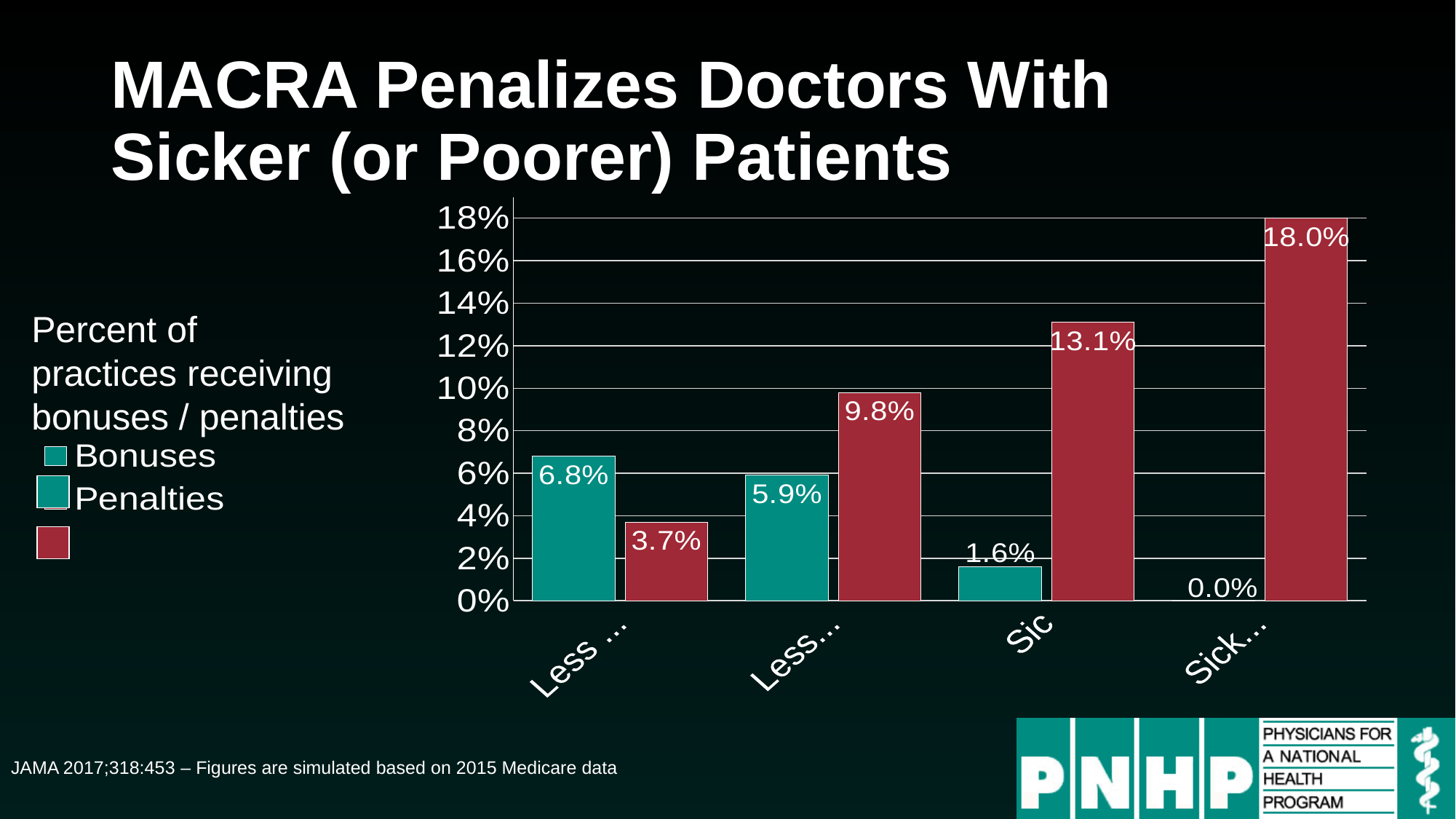
What is the Penalties value for the second category group from the left? 9.8% What is the difference between the Penalties value and the Bonuses value in the third category group from the left? 11.5% What is the Bonuses value for the third category group from the left? 1.6% How many series does the chart's legend list? 2 What is the Penalties value for the rightmost category group? 18.0% How many category groups are plotted along the x axis? 4 In the leftmost category group, which is larger: the Bonuses bar or the Penalties bar? Bonuses Which series has the highest value on the chart, and what is it? Penalties, 18.0% What kind of chart is shown on the slide? bar chart What is the lowest Bonuses value shown on the chart? 0.0% What is the Bonuses value for the leftmost category group? 6.8% Do the Penalties values rise or fall moving from left to right along the x axis? rise